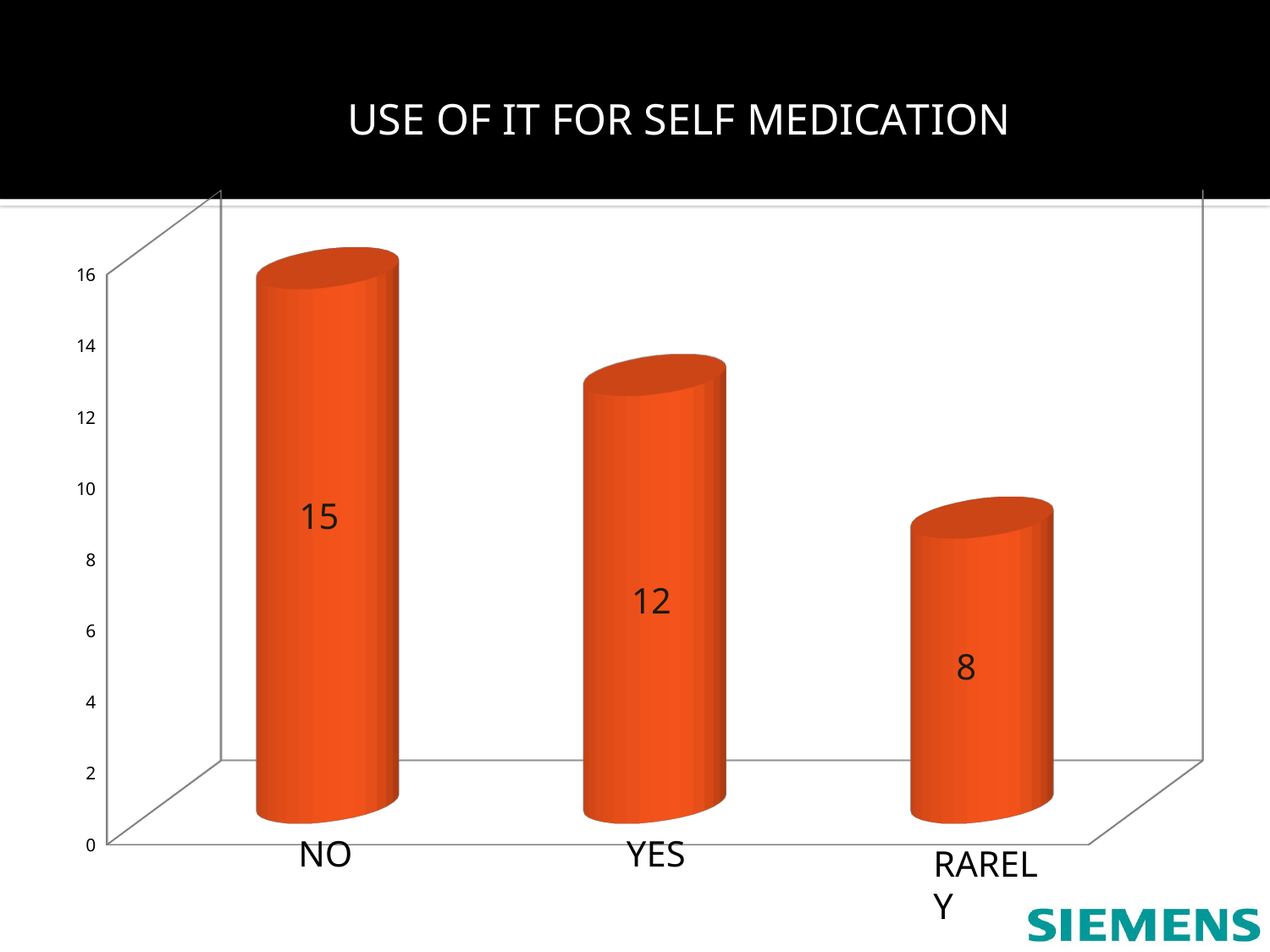
What is the value for YES? 12 What is the value for RARELY? 8 Which category has the lowest value? RARELY What is the title of the chart? USE OF IT FOR SELF MEDICATION Is the value for NO greater or less than 14? greater How many categories are shown in the chart? 3 Which category has the highest value? NO What is the difference between the values for NO and YES? 3 What is the value for NO? 15 What kind of chart is shown on the slide? bar chart Which is larger, the value for YES or the value for RARELY? YES What is the difference between the values for YES and RARELY? 4